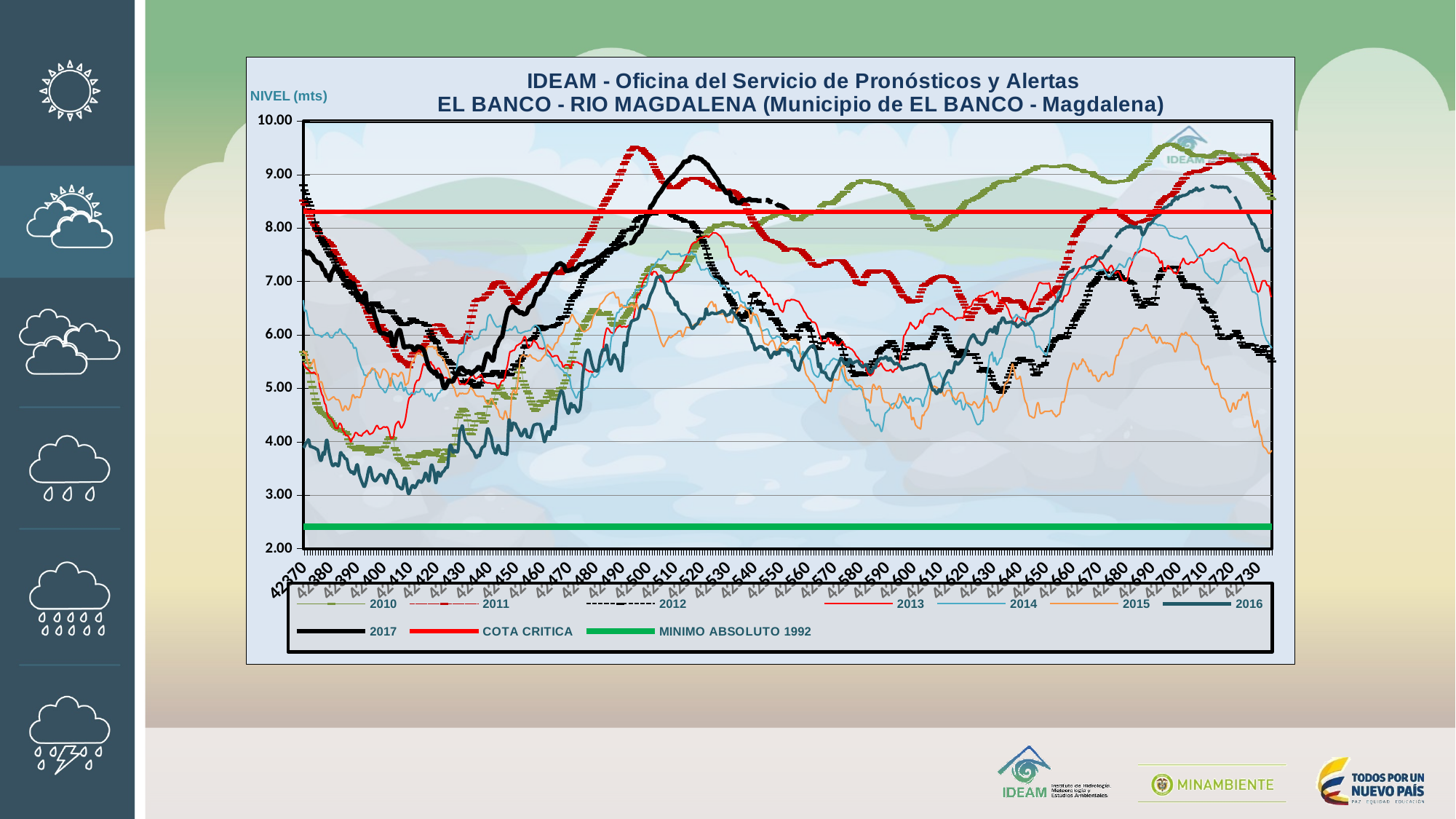
Is the value for the 2015 series at 42730 greater or less than 5.00? less At 42410, which series has the larger value, 2016 or 2017? 2017 Is the peak value of the 2011 series near 42500 greater or less than 9.00? greater Is the value for the 2016 series at 42410 greater or less than 4.00? less What is the label of the vertical axis? NIVEL (mts) What is the highest value shown on the vertical axis? 10.00 How many series does the legend list? 10 Which series is drawn as a thick green horizontal line? MINIMO ABSOLUTO 1992 What kind of chart is shown on the slide? line chart